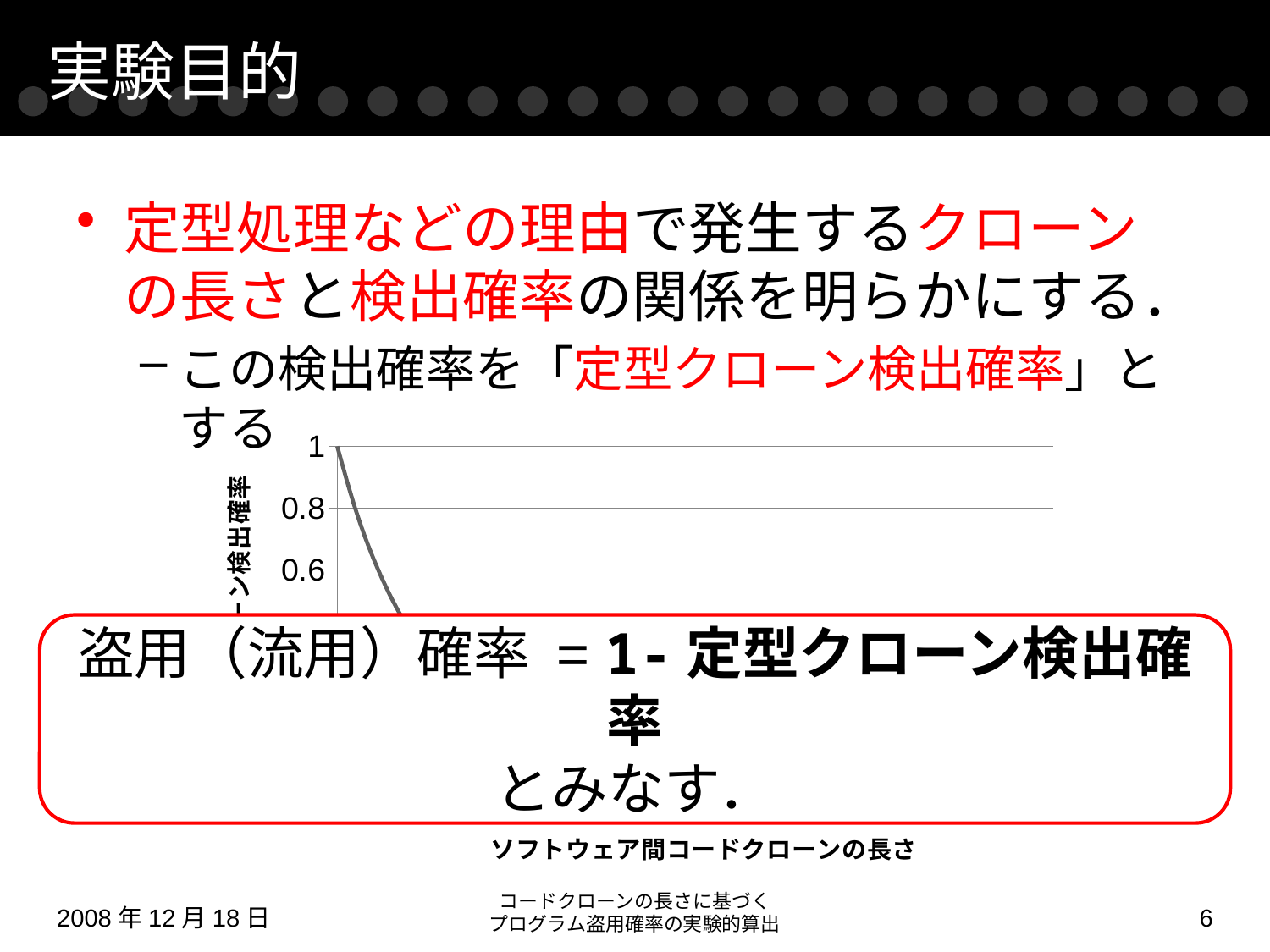
What is the title of the x axis of the chart? ソフトウェア間コードクローンの長さ What kind of chart is shown on the slide? line chart Do the values in the chart rise or fall as the x axis increases? fall What value does the curve start at on the left edge of the chart? 1 What is the highest value shown on the y axis of the chart? 1